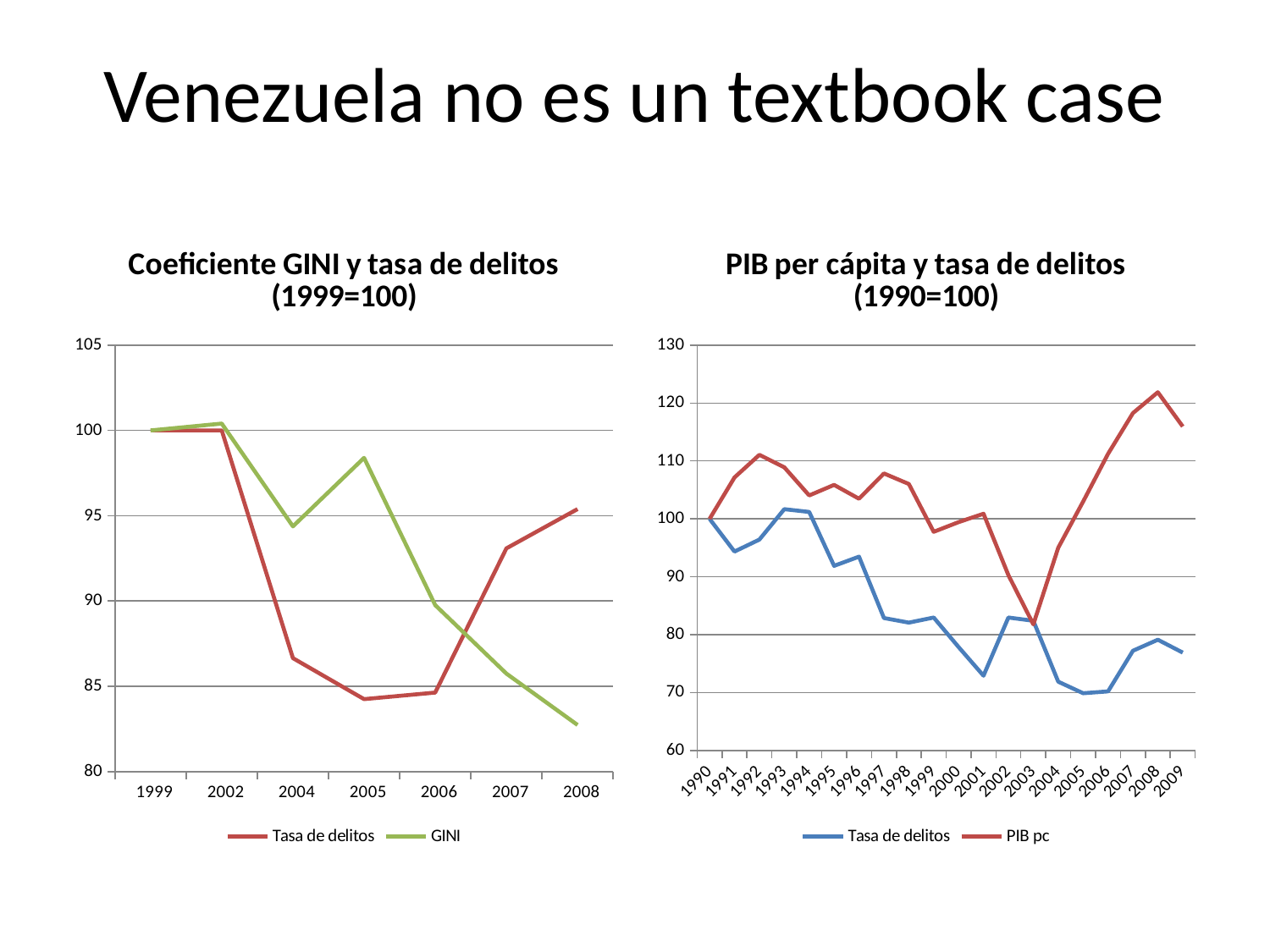
How many years are plotted on the x axis of the left chart, 'Coeficiente GINI y tasa de delitos (1999=100)'? 7 In the right chart, 'PIB per cápita y tasa de delitos (1990=100)', does PIB pc rise or fall from 2003 to 2008? Rise In the left chart, 'Coeficiente GINI y tasa de delitos (1999=100)', in which year is Tasa de delitos lowest? 2005 In the left chart, 'Coeficiente GINI y tasa de delitos (1999=100)', is the value of GINI in 2008 greater or less than 85? less How many series does the legend of the right chart, 'PIB per cápita y tasa de delitos (1990=100)', list? 2 In the right chart, 'PIB per cápita y tasa de delitos (1990=100)', what is the value of PIB pc in 1990? 100 What kind of chart is the left chart, 'Coeficiente GINI y tasa de delitos (1999=100)'? Line chart In the right chart, 'PIB per cápita y tasa de delitos (1990=100)', in which year is PIB pc highest? 2008 In the right chart, 'PIB per cápita y tasa de delitos (1990=100)', is the value of PIB pc in 2008 greater or less than 120? greater In the left chart, 'Coeficiente GINI y tasa de delitos (1999=100)', what colour is the GINI line? Green In the left chart, 'Coeficiente GINI y tasa de delitos (1999=100)', which series has the larger value in 2006, GINI or Tasa de delitos? GINI In the left chart, 'Coeficiente GINI y tasa de delitos (1999=100)', what is the value of Tasa de delitos in 1999? 100